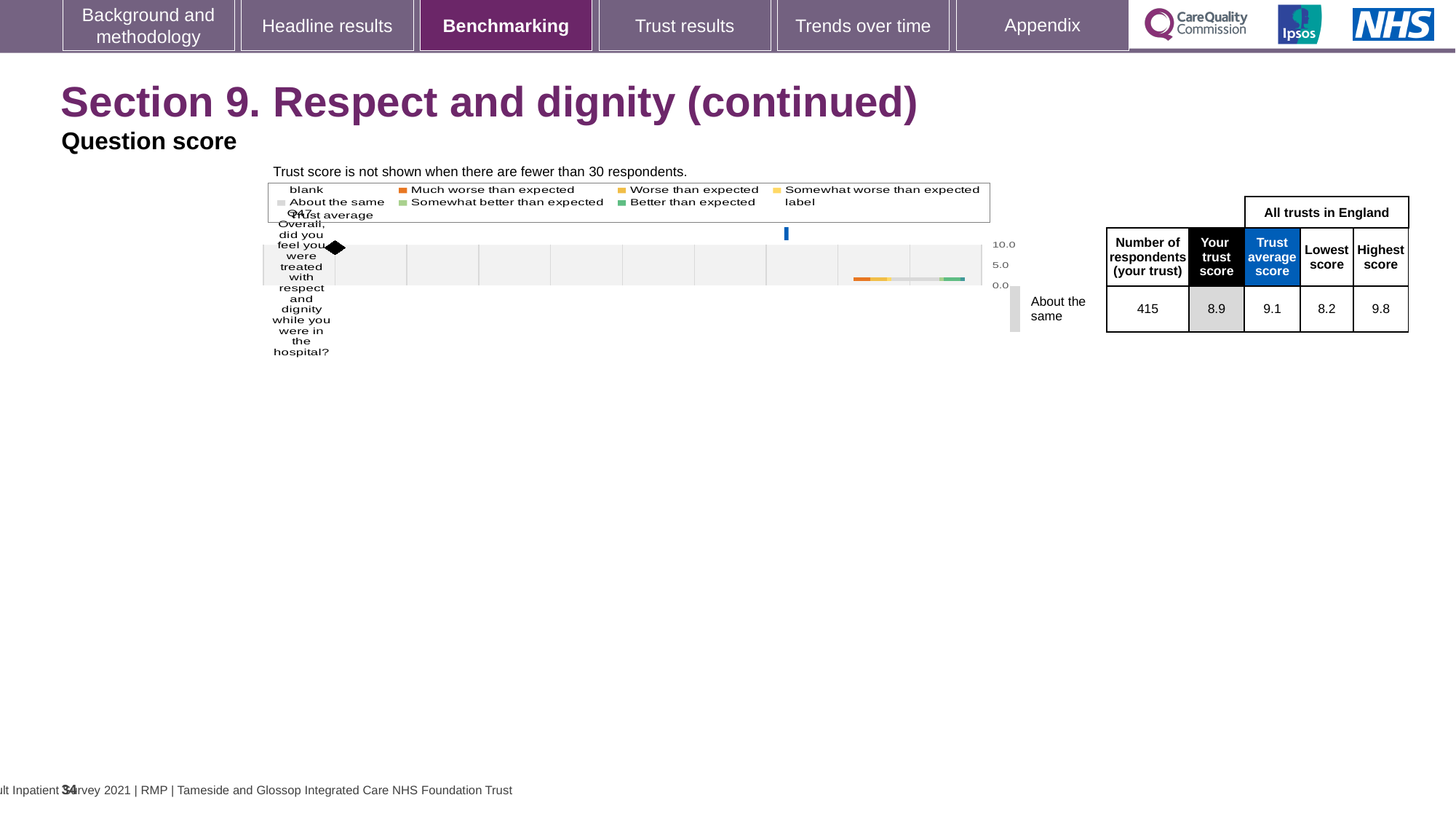
In the table beside the chart, what is the highest score among all trusts in England? 9.8 What kind of chart is shown on the slide? bar chart In the table beside the chart, what is the lowest score among all trusts in England? 8.2 In the table beside the chart, what is the number of respondents for your trust? 415 How many question categories are plotted on the chart? 1 In the table beside the chart, what is the trust average score? 9.1 What is the highest value shown on the chart's axis? 10.0 Which is larger, your trust score or the trust average score? Trust average score In the table beside the chart, what is your trust score for Q47? 8.9 What benchmark category is given for your trust's score on Q47? About the same Which question number is labelled on the chart's category axis? Q47 What is the difference between the highest score and the lowest score in the table beside the chart? 1.6